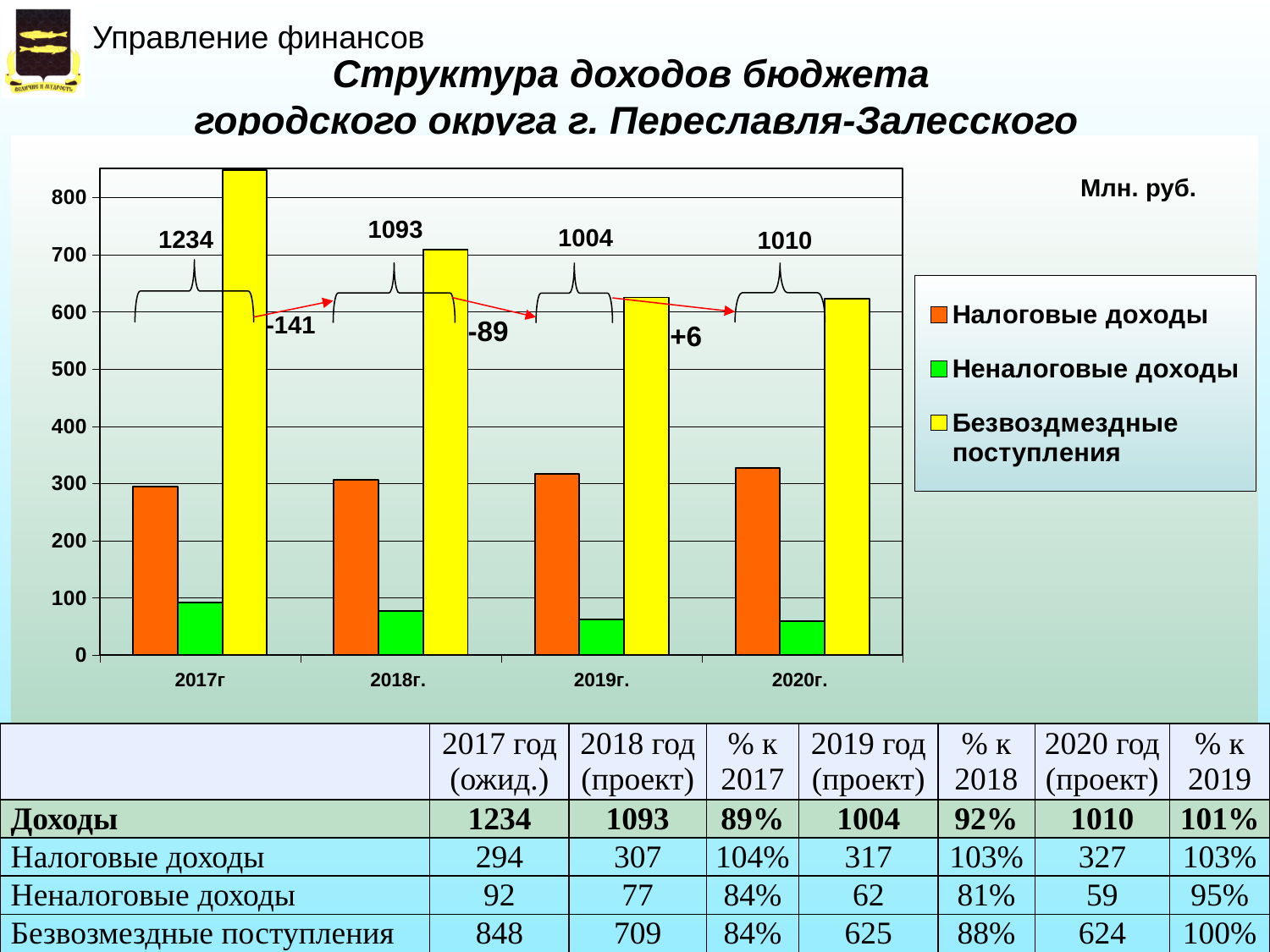
Which colour represents Безвоздмездные поступления in the chart legend? yellow What change in total income is labelled on the arrow from 2017г to 2018г? -141 In which year is the Неналоговые доходы bar the highest? 2017г How many series does the chart legend list? 3 What total income (Доходы) is labelled above the bars for 2017г? 1234 Is the Налоговые доходы value for 2019г. greater or less than 300? greater What kind of chart is shown on the slide? bar chart What change in total income is labelled on the arrow from 2019г. to 2020г.? +6 In which year is the Безвоздмездные поступления bar the highest? 2017г In 2018г., which is larger: Налоговые доходы or Неналоговые доходы? Налоговые доходы How many years are shown along the x axis of the chart? 4 Do the Безвоздмездные поступления values rise or fall from 2017г to 2020г.? fall